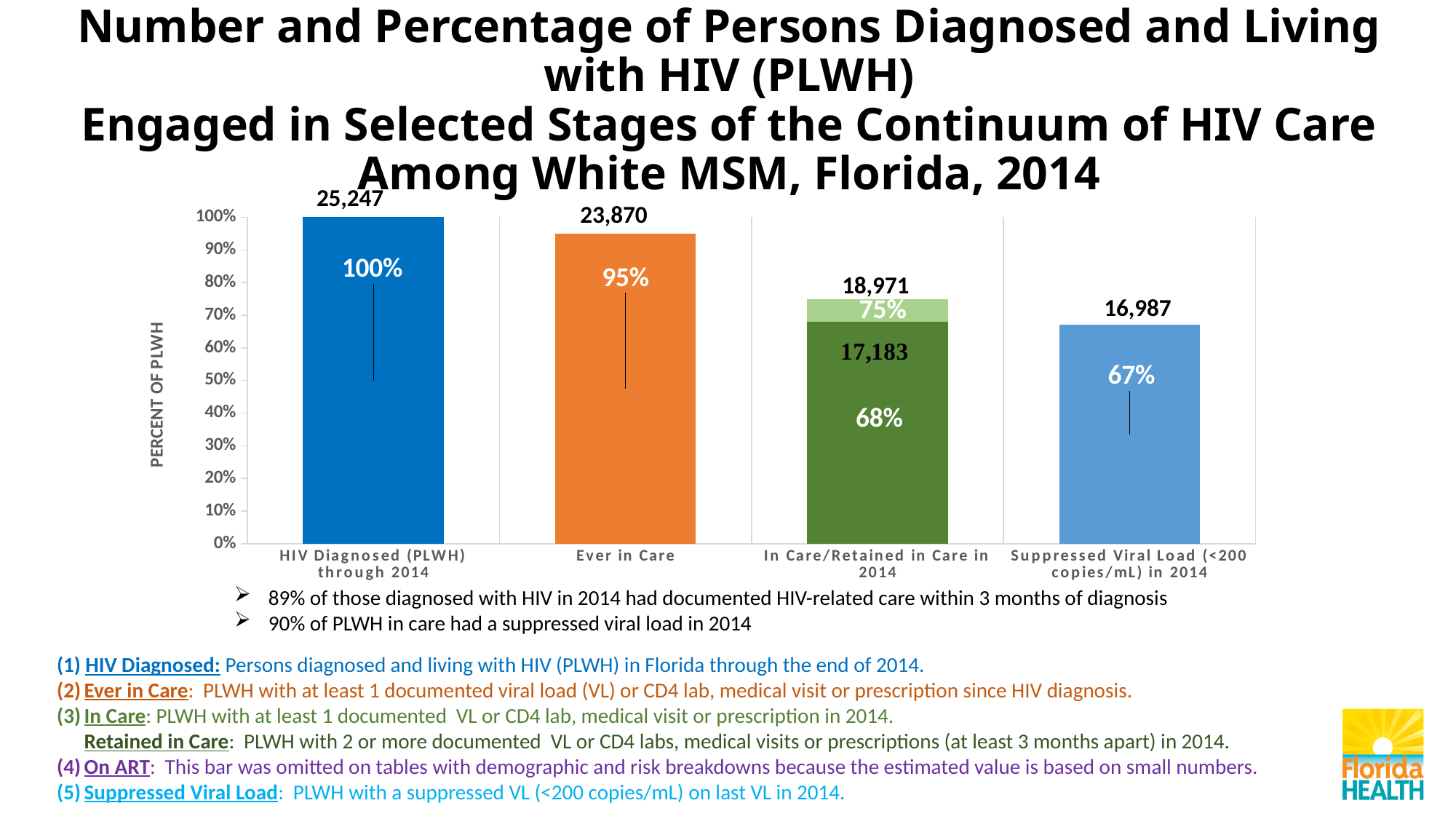
Which is larger, the percentage for Ever in Care or the percentage for Suppressed Viral Load (<200 copies/mL) in 2014? Ever in Care Which category has the lowest percentage of PLWH? Suppressed Viral Load (<200 copies/mL) in 2014 What number is printed above the bar for HIV Diagnosed (PLWH) through 2014? 25,247 What percentage is shown for the Retained in Care portion (dark green) of the In Care/Retained in Care in 2014 bar? 68% What number is printed at the top of the In Care/Retained in Care in 2014 bar? 18,971 What is the difference in number of persons between HIV Diagnosed (PLWH) through 2014 and Ever in Care? 1,377 What percentage is shown for the Ever in Care bar? 95% Do the percentages rise or fall moving from left to right across the chart? fall Which category has the highest number of persons? HIV Diagnosed (PLWH) through 2014 How many categories are shown on the x axis of the chart? 4 What number is printed above the Suppressed Viral Load (<200 copies/mL) in 2014 bar? 16,987 What percentage is shown for the Suppressed Viral Load (<200 copies/mL) in 2014 bar? 67%